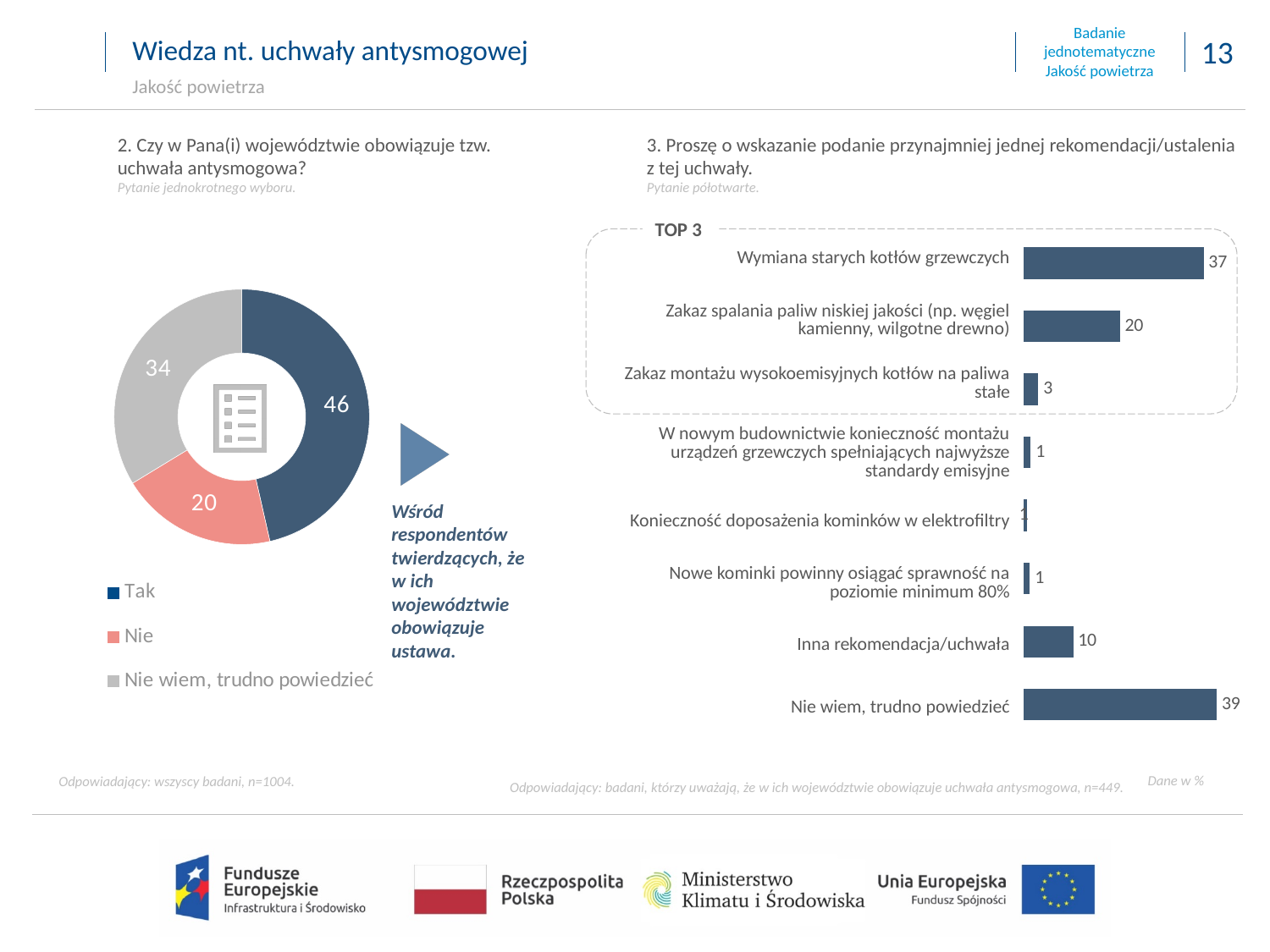
In the bar chart on the right, which category has the highest value? Nie wiem, trudno powiedzieć In the donut chart on the left, how many categories does the legend list? 3 In the bar chart on the right, what is the value for "Zakaz spalania paliw niskiej jakości (np. węgiel kamienny, wilgotne drewno)"? 20 In the bar chart on the right, which is larger: "Inna rekomendacja/uchwała" or "Zakaz montażu wysokoemisyjnych kotłów na paliwa stałe"? Inna rekomendacja/uchwała In the donut chart on the left, which answer has the largest share? Tak In the donut chart on the left, what is the value for "Nie"? 20 In the bar chart on the right, what is the difference between "Nie wiem, trudno powiedzieć" and "Wymiana starych kotłów grzewczych"? 2 In the donut chart on the left, what percentage of respondents answered "Tak"? 46 In the donut chart on the left, what is the value for "Nie wiem, trudno powiedzieć"? 34 What type of chart is shown on the left side of the slide? Donut (pie) chart In the bar chart on the right, what is the value for "Wymiana starych kotłów grzewczych"? 37 What type of chart is shown on the right side of the slide? Bar chart